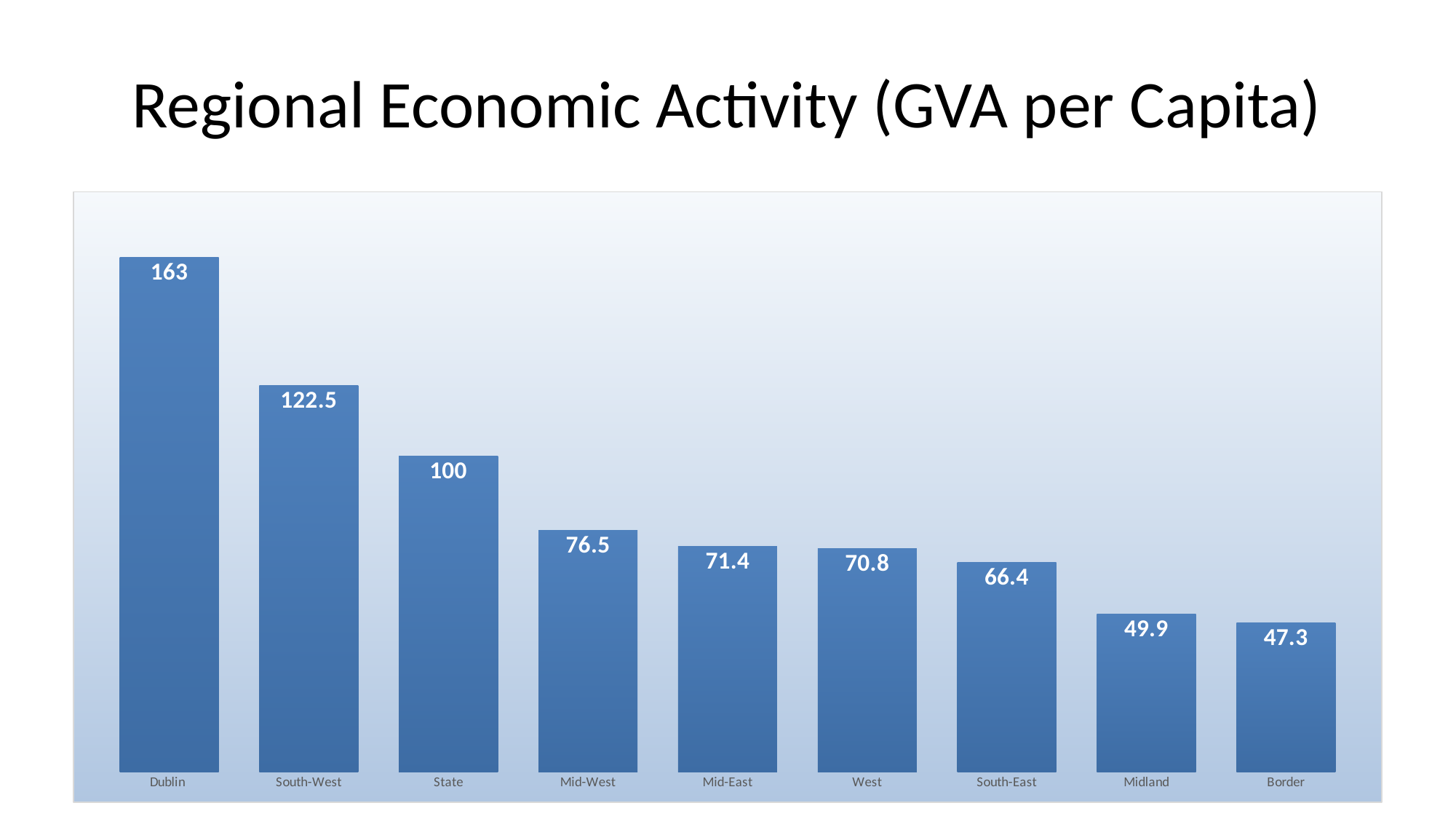
What is the difference between the values for Dublin and State? 63 What is the value for Border? 47.3 What is the value for Dublin? 163 What is the value for Mid-East? 71.4 How many categories are shown on the x axis? 9 Which category has the lowest value? Border What is the difference between the values for Midland and Border? 2.6 What is the value for South-West? 122.5 Which region has the highest value? Dublin Do the values rise or fall from left to right along the x axis? Fall What kind of chart is shown on the slide? Bar chart Which is larger, the value for Mid-West or the value for West? Mid-West